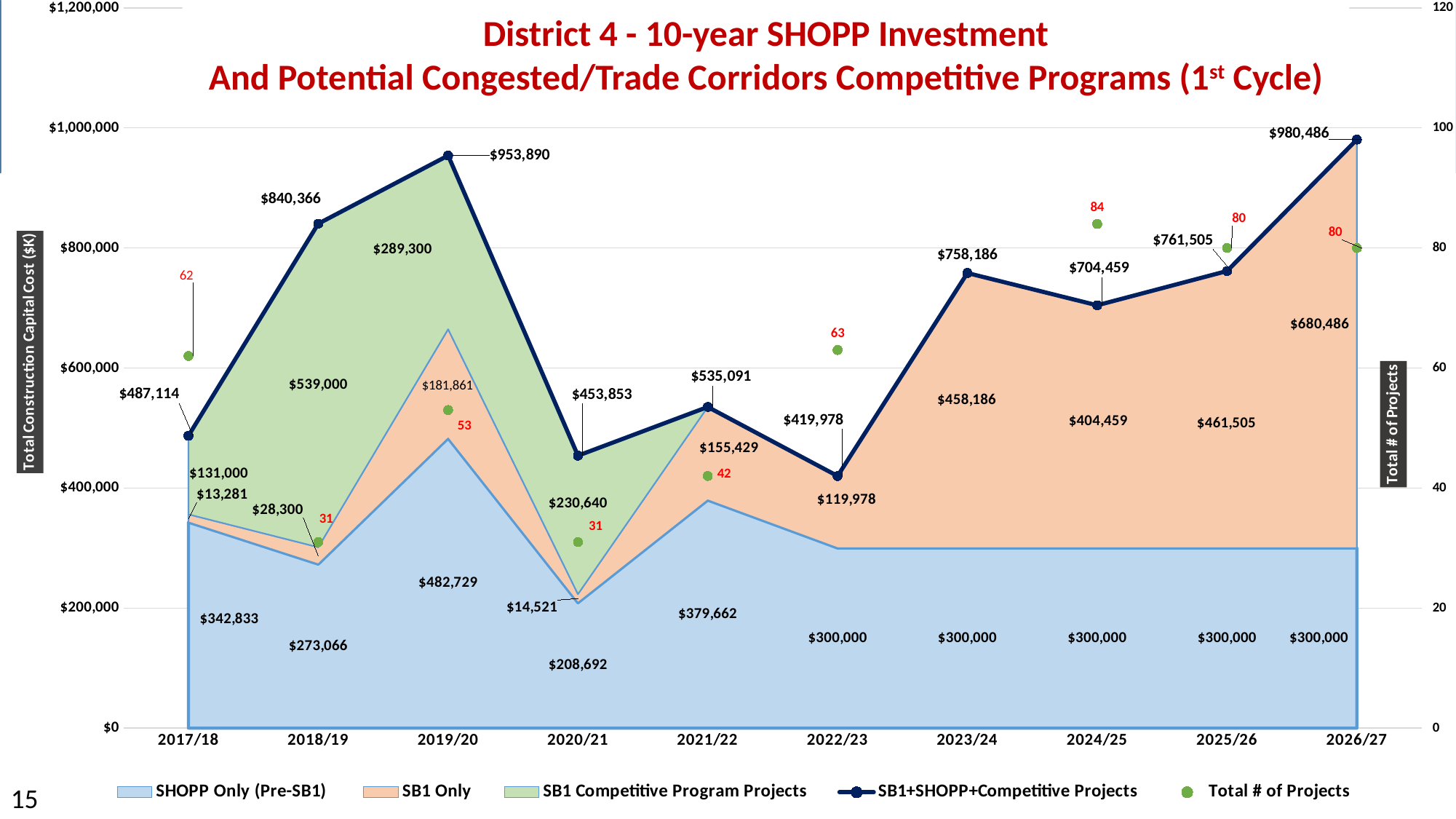
Which year has the highest SB1+SHOPP+Competitive Projects total? 2026/27 What is the Total # of Projects for 2024/25? 84 How many fiscal years are shown on the x axis? 10 Which year has the lowest SB1+SHOPP+Competitive Projects total? 2022/23 What is the SB1 Competitive Program Projects value for 2018/19? $539,000 What is the difference between the SB1+SHOPP+Competitive Projects totals for 2026/27 and 2019/20? $26,596 How many series does the legend list? 5 Which is larger, the SB1 Only value for 2025/26 or for 2024/25? 2025/26 What is the SHOPP Only (Pre-SB1) value for 2018/19? $273,066 Does the SHOPP Only (Pre-SB1) value rise or fall from 2019/20 to 2020/21? fall What is the SB1 Only value for 2026/27? $680,486 What is the SB1+SHOPP+Competitive Projects total for 2019/20? $953,890